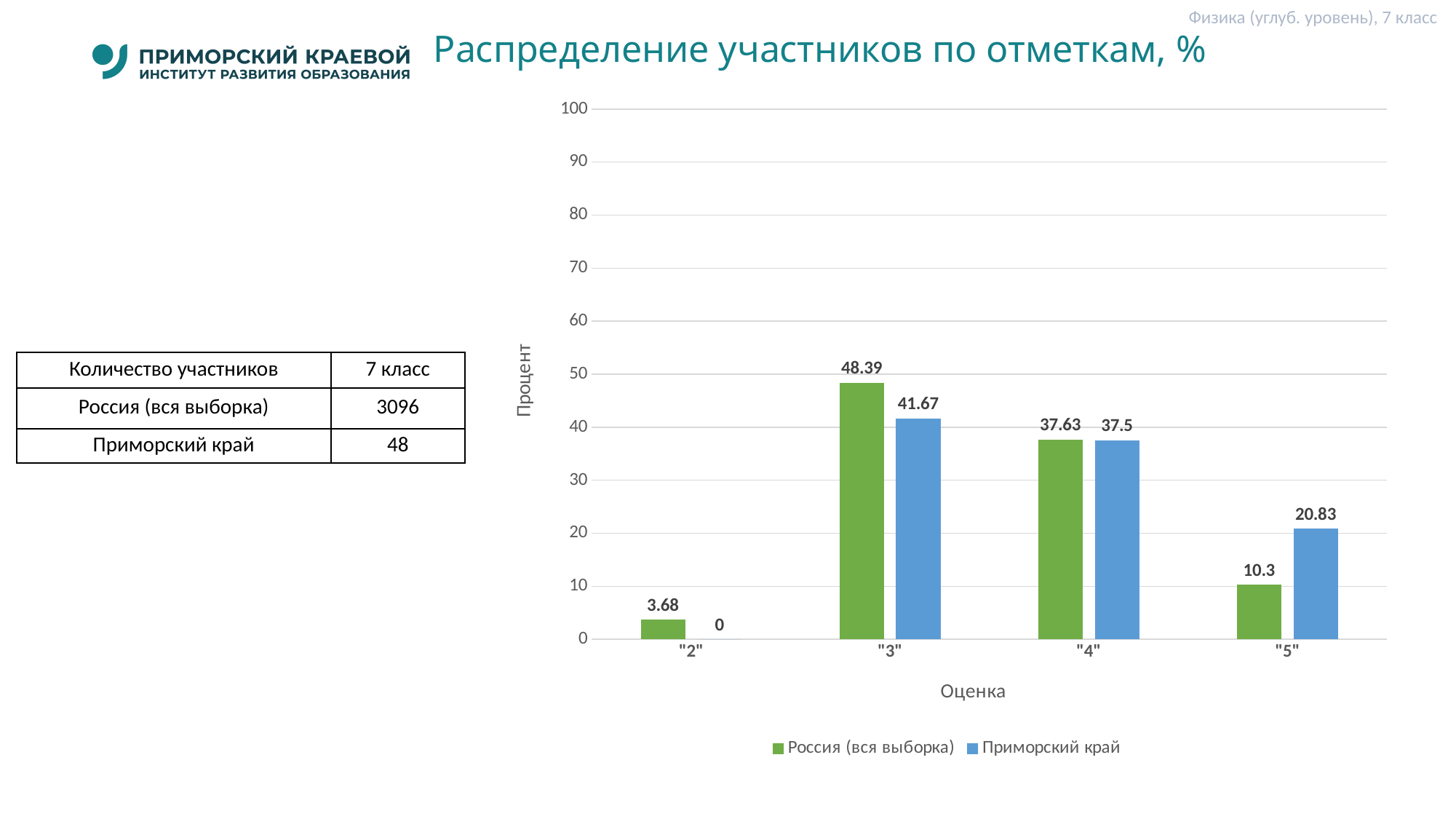
Which grade has the highest value for Россия (вся выборка)? "3" What is the value for Приморский край at grade "5"? 20.83 How many grade categories are shown on the x axis? 4 What is the value for Приморский край at grade "2"? 0 What is the label of the y axis? Процент What kind of chart is shown on the slide? bar chart Is the value for Приморский край at grade "4" greater or less than 30? greater Which is larger at grade "3": Россия (вся выборка) or Приморский край? Россия (вся выборка) What is the value for Россия (вся выборка) at grade "3"? 48.39 Which grade has the lowest value for Приморский край? "2" How many series does the legend list? 2 What is the difference between Россия (вся выборка) and Приморский край at grade "5"? 10.53